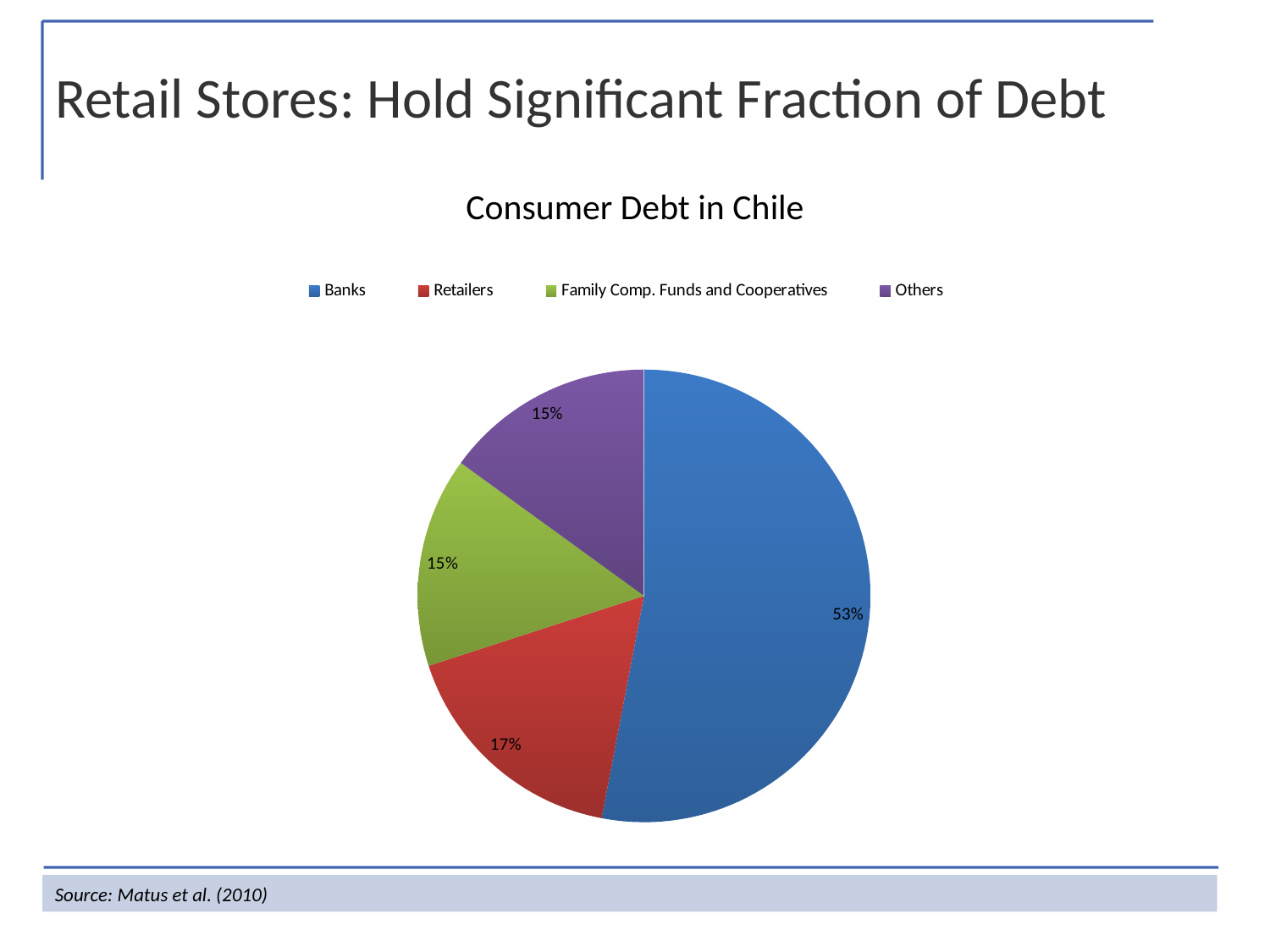
How many categories does the legend list? 4 What share of consumer debt in Chile is held by Family Comp. Funds and Cooperatives? 15% What is the difference in percentage points between the Banks share and the Retailers share? 36 What type of chart is shown on the slide? Pie chart Which holds a larger share of consumer debt, Retailers or Others? Retailers What share of consumer debt in Chile is held by Others? 15% What share of consumer debt in Chile is held by Banks? 53% What is the title of the chart? Consumer Debt in Chile What share of consumer debt in Chile is held by Retailers? 17% Which category holds the largest share of consumer debt in Chile? Banks What colour represents Retailers in the pie chart? Red What is the combined share of Family Comp. Funds and Cooperatives and Others? 30%